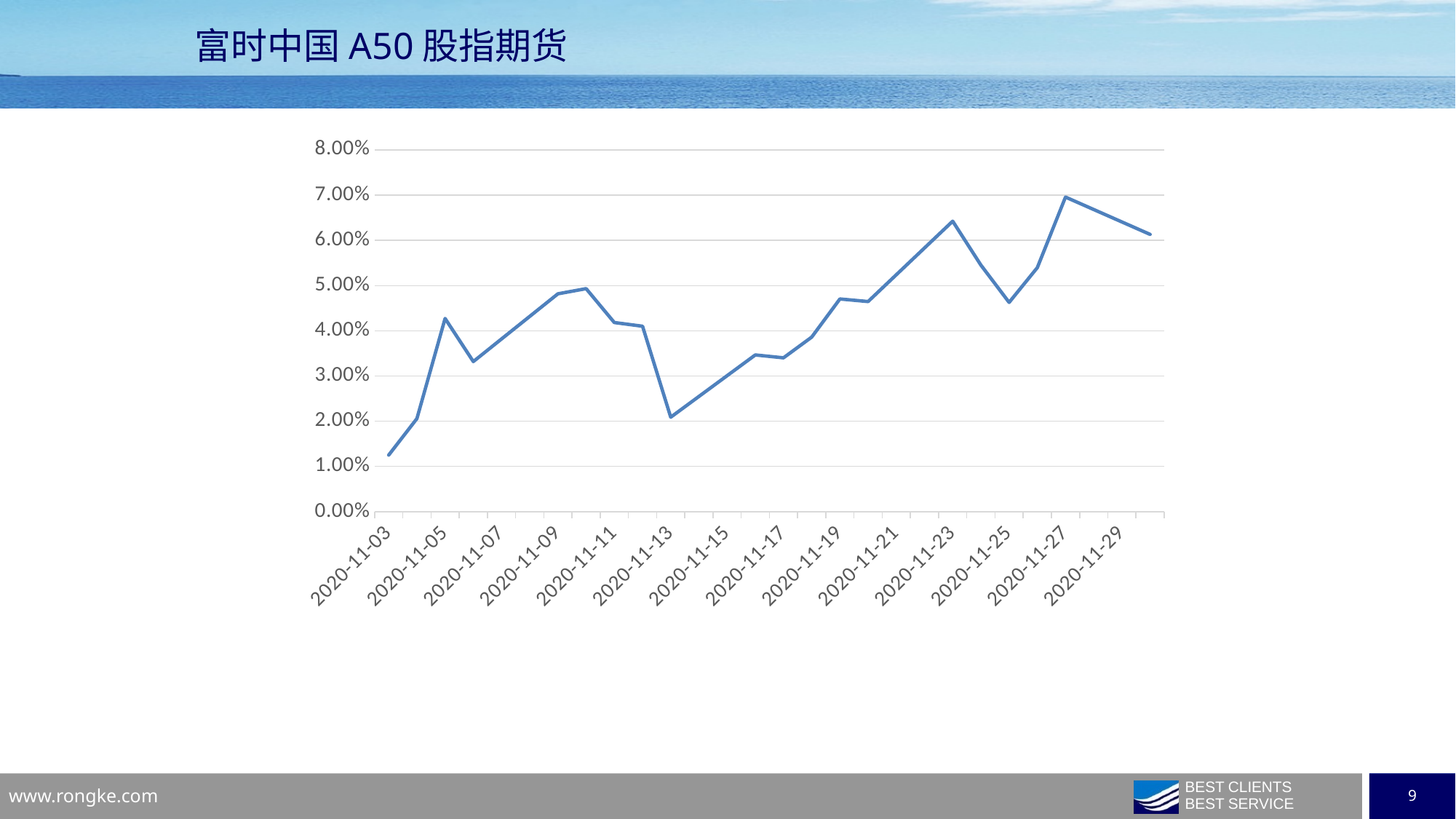
Is the value for 2020-11-13 greater or less than 3.00%? less On which date does the line reach its highest value? 2020-11-27 Is the value for 2020-11-03 greater or less than 2.00%? less On which date does the line reach its lowest value? 2020-11-03 Which date has the larger value, 2020-11-05 or 2020-11-13? 2020-11-05 Is the value for 2020-11-27 greater or less than 6.00%? greater What is the title of the chart? 富时中国 A50 股指期货 Which date has the larger value, 2020-11-23 or 2020-11-25? 2020-11-23 What kind of chart is shown on the slide? line chart Overall, does the line rise or fall from 2020-11-03 to the end of the period? rise What is the highest value shown on the vertical axis? 8.00%